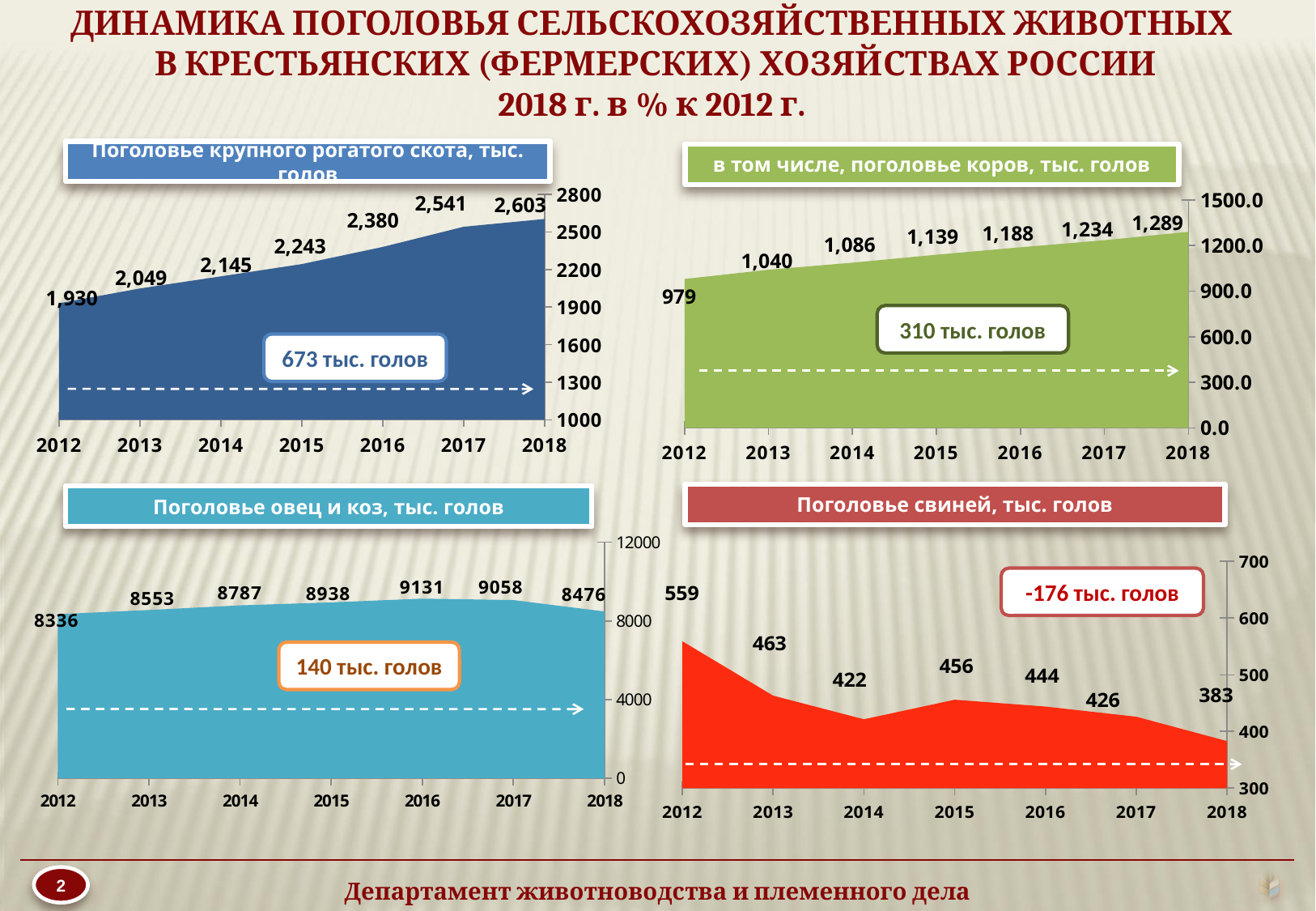
In the chart 'в том числе, поголовье коров, тыс. голов', what is the value for 2015? 1,139 In the chart 'Поголовье свиней, тыс. голов', what is the value for 2014? 422 In the chart 'Поголовье крупного рогатого скота, тыс. голов', what is the value for 2018? 2,603 In the chart 'Поголовье свиней, тыс. голов', do the values generally rise or fall from 2012 to 2018? fall In the chart 'Поголовье свиней, тыс. голов', is the value for 2015 larger or smaller than the value for 2017? larger In the chart 'Поголовье овец и коз, тыс. голов', which year has the highest value? 2016 In the chart 'в том числе, поголовье коров, тыс. голов', which year has the lowest value? 2012 In the chart 'Поголовье овец и коз, тыс. голов', what is the difference between the 2016 value and the 2012 value? 795 How many years are plotted in the chart 'Поголовье крупного рогатого скота, тыс. голов'? 7 What kind of chart is 'в том числе, поголовье коров, тыс. голов'? area chart In the chart 'Поголовье крупного рогатого скота, тыс. голов', what is the value for 2012? 1,930 In the chart 'Поголовье свиней, тыс. голов', which year has the lowest value? 2018